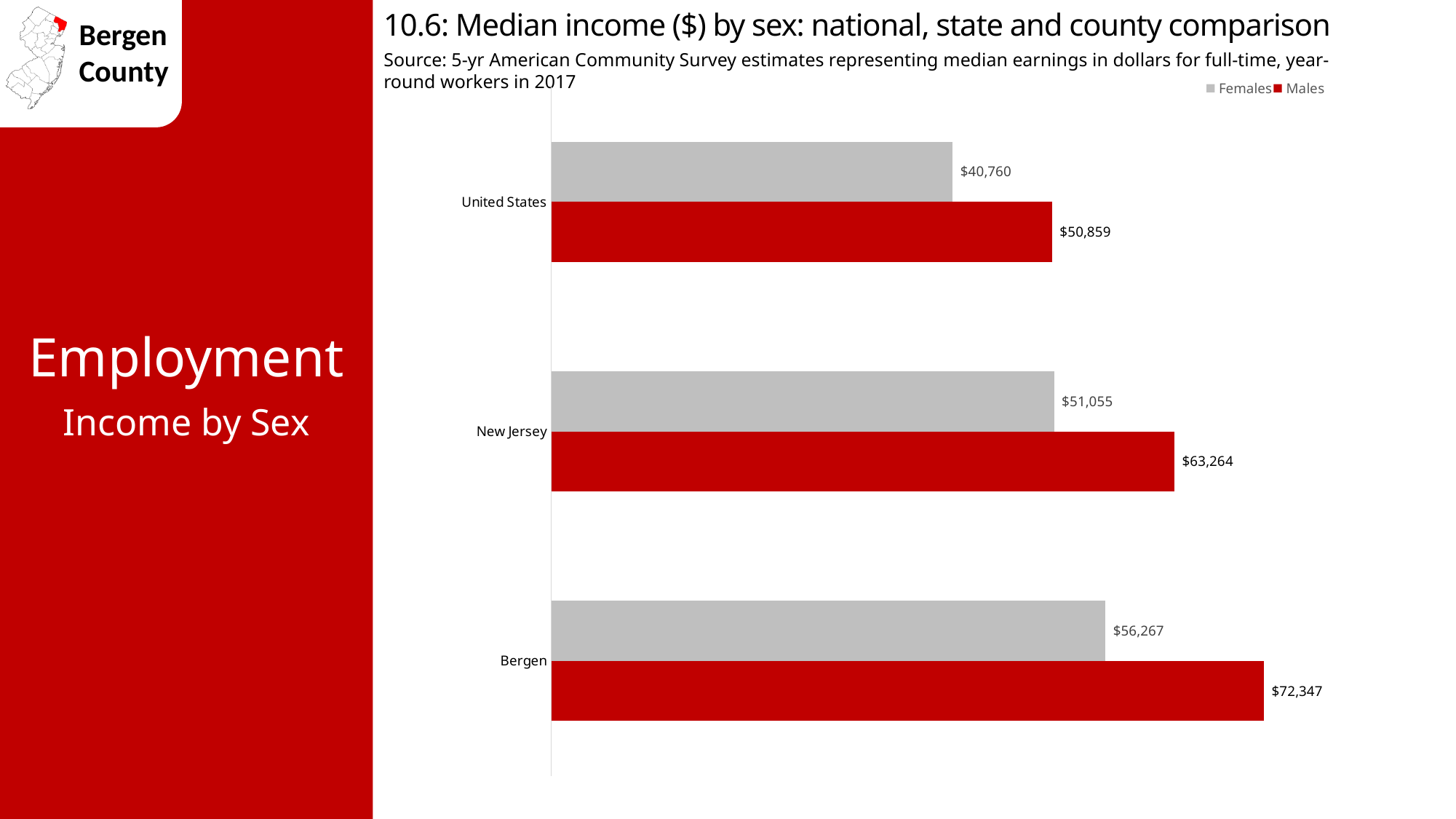
Which category has the highest median income for males? Bergen What is the difference between male and female median income in New Jersey? $12,209 What is the median income for males in Bergen? $72,347 What is the difference between male and female median income in Bergen? $16,080 Which is larger: the median income for females in New Jersey or for males in the United States? Females in New Jersey What is the median income for males in New Jersey? $63,264 What is the median income for females in Bergen? $56,267 How many series does the legend list? 2 How many geographic categories are shown in the chart? 3 What type of chart is shown on the slide? Bar chart Which category has the lowest median income for females? United States What is the median income for females in the United States? $40,760